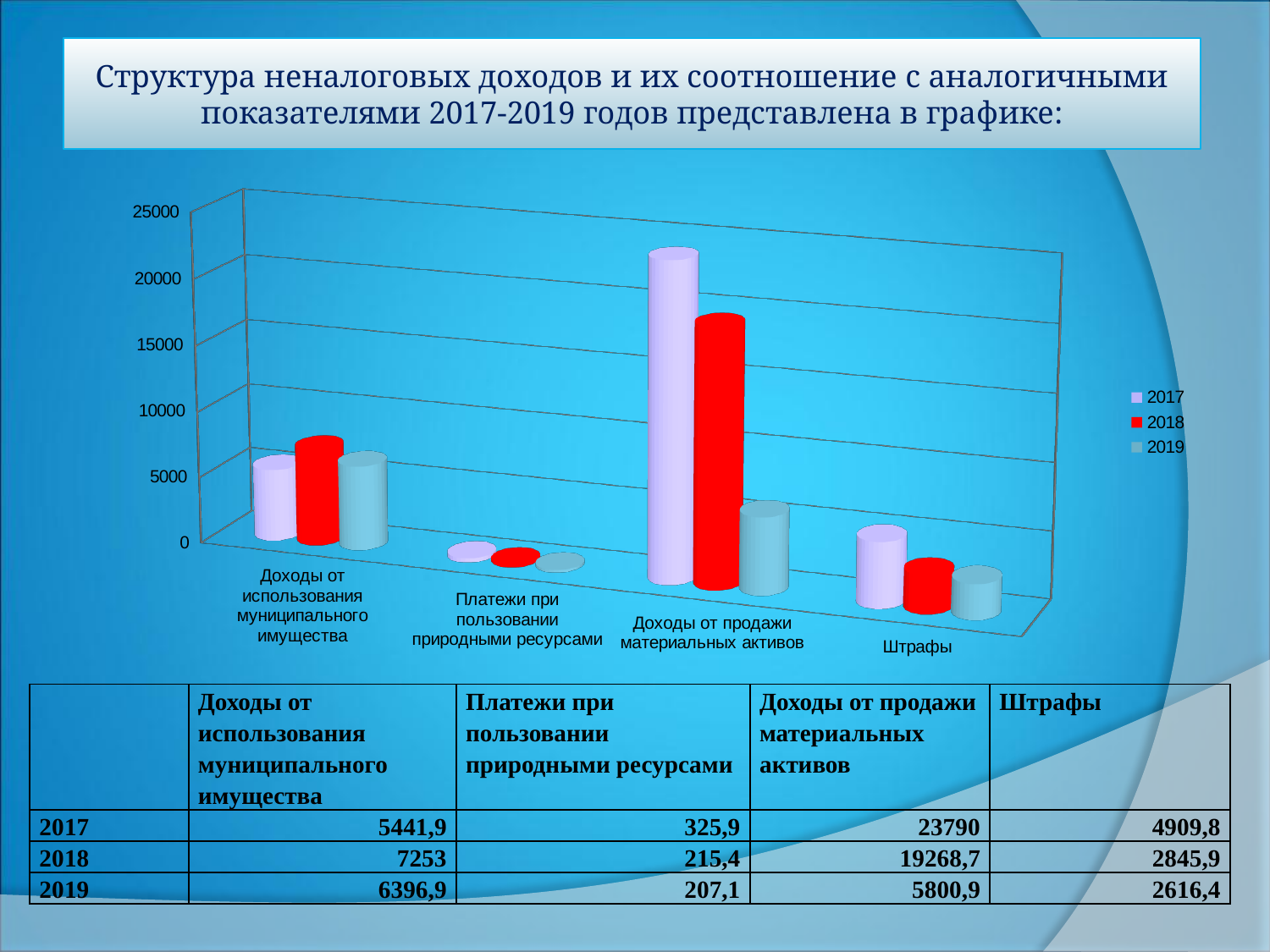
Is the 2017 value for "Доходы от продажи материальных активов" greater or less than 20000? greater How many series does the legend list? 3 Which category has the highest value for 2017? Доходы от продажи материальных активов How many categories are shown on the x axis of the chart? 4 What is the difference between the 2017 and 2018 values for "Доходы от продажи материальных активов"? 4521,3 What is the value for 2018 in the category "Доходы от использования муниципального имущества"? 7253 Which is larger for "Штрафы": the 2017 value or the 2018 value? 2017 What is the value for 2017 in the category "Доходы от продажи материальных активов"? 23790 Which category has the lowest value for 2019? Платежи при пользовании природными ресурсами Do the values for "Штрафы" rise or fall from 2017 to 2019? fall What is the value for 2019 in the category "Штрафы"? 2616,4 What kind of chart is shown on the slide? bar chart